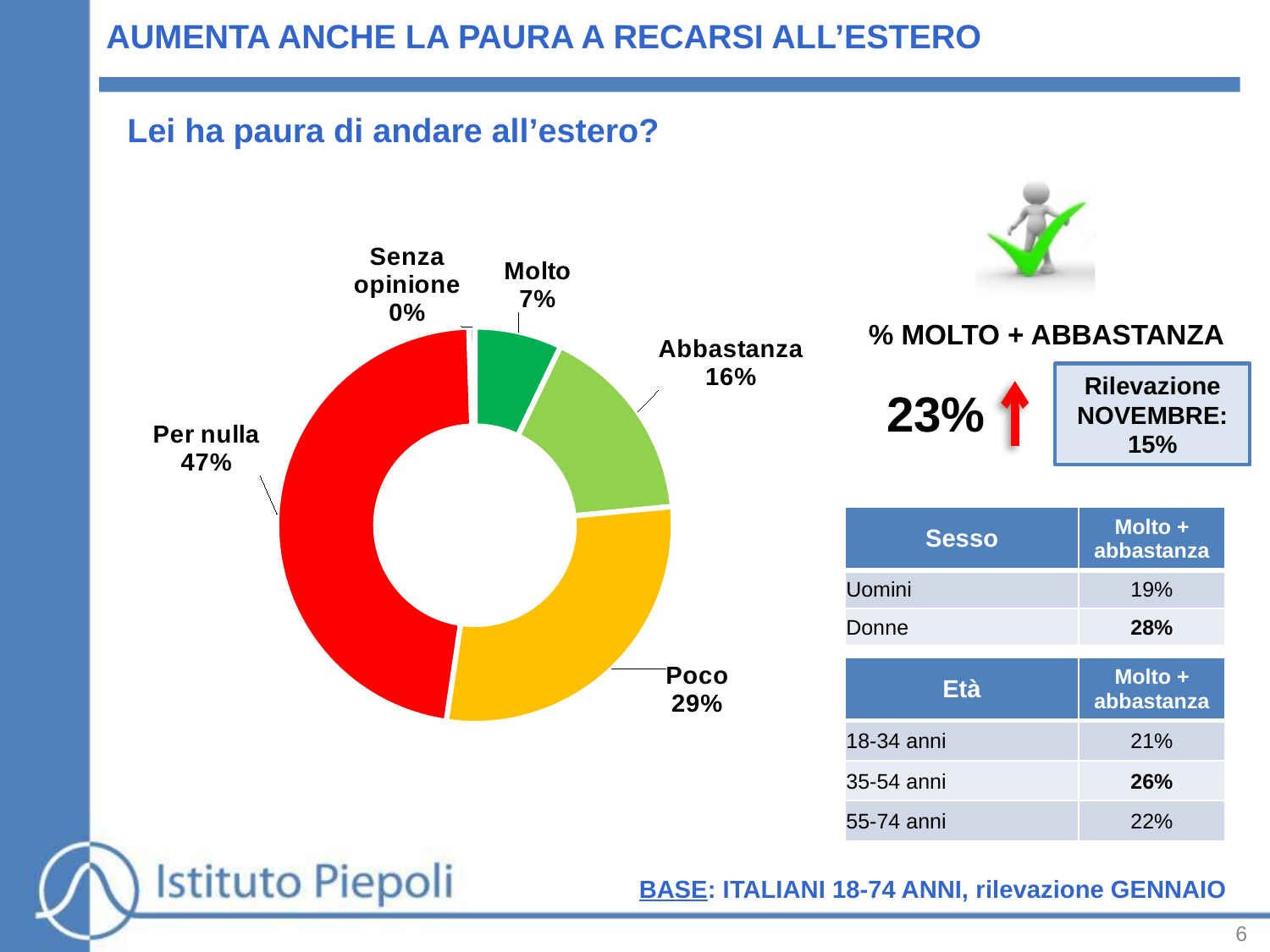
What percentage of respondents answered "Poco"? 29% Which is larger, the share for "Abbastanza" or the share for "Molto"? Abbastanza What percentage of respondents answered "Molto"? 7% Which category has the smallest share of the chart? Senza opinione What is the difference in percentage points between "Per nulla" and "Poco"? 18 What kind of chart is shown on the slide? Doughnut (pie) chart What percentage of respondents answered "Per nulla"? 47% Which category has the largest share of the chart? Per nulla How many categories are shown in the chart? 5 What percentage of respondents answered "Abbastanza"? 16% What colour is the "Per nulla" segment of the chart? Red What percentage is shown for "Senza opinione"? 0%